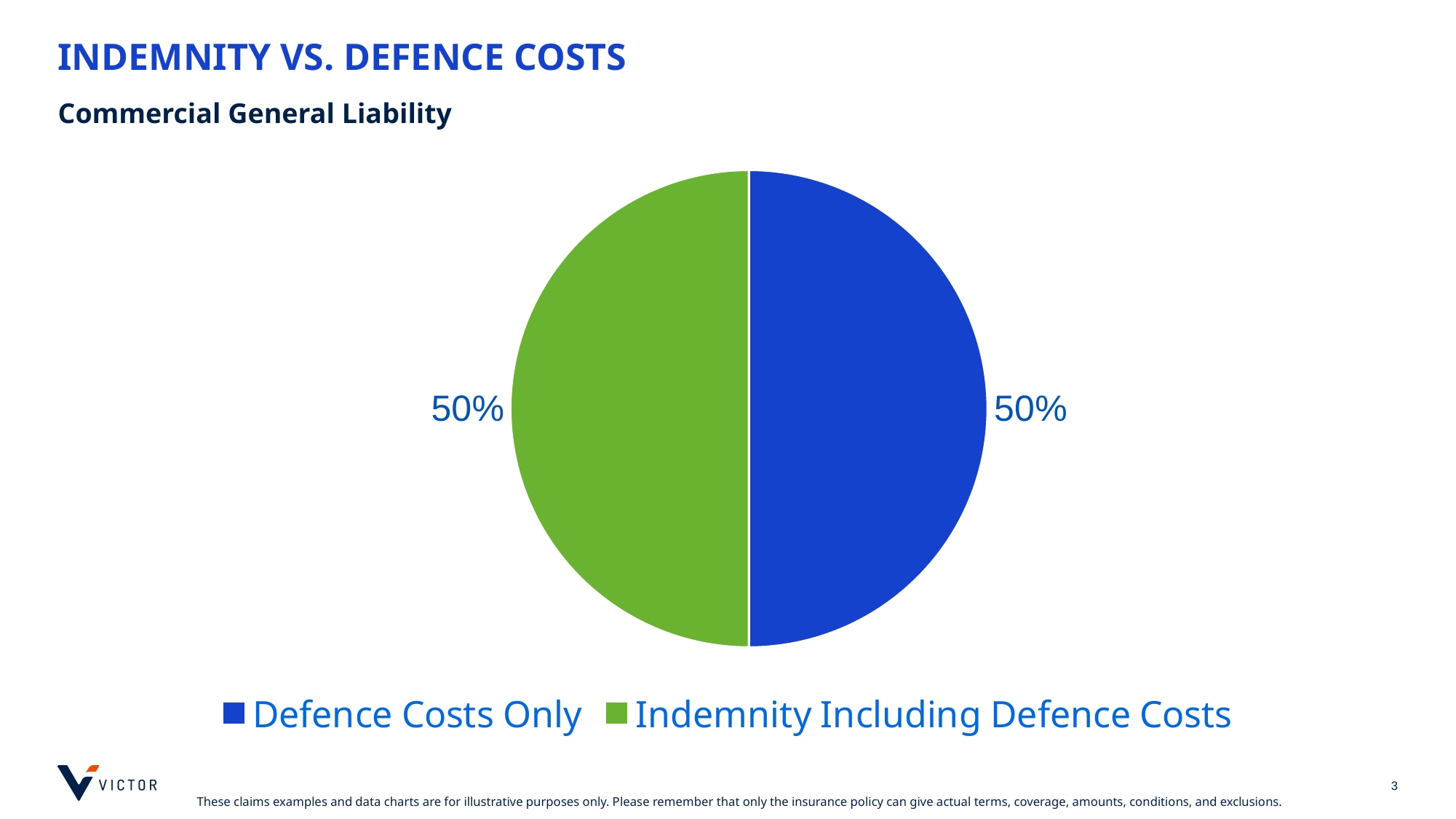
What share of the pie does Defence Costs Only represent? 50% How many slices does the pie chart have? 2 How many entries does the legend list? 2 What is the difference between the Defence Costs Only share and the Indemnity Including Defence Costs share? 0% What kind of chart is shown on the slide? pie chart Which colour represents Defence Costs Only in the pie chart? blue Which colour represents Indemnity Including Defence Costs in the pie chart? green What is the combined share of Defence Costs Only and Indemnity Including Defence Costs? 100% What share of the pie does Indemnity Including Defence Costs represent? 50%